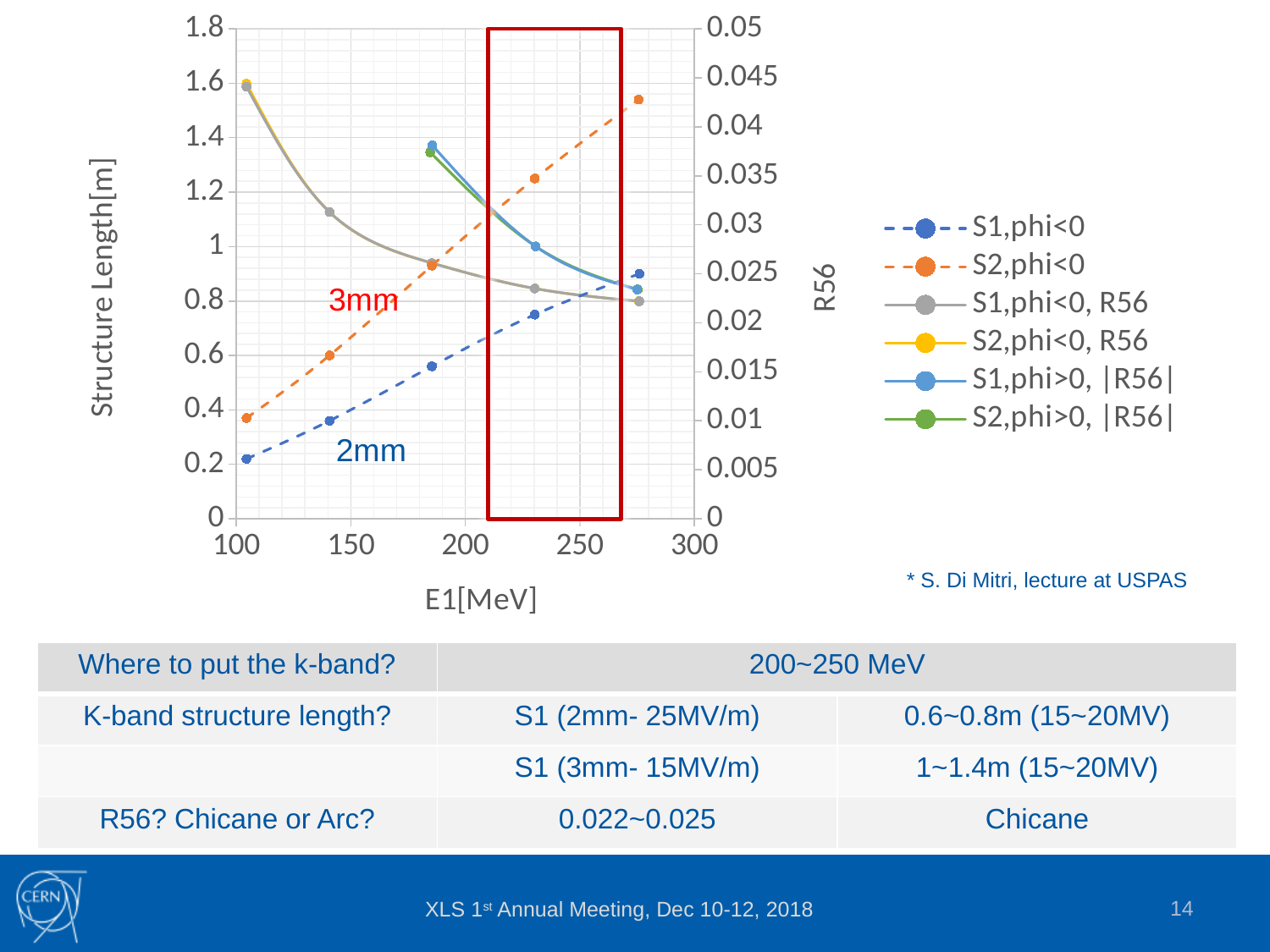
Is the structure length for S1,phi<0 at its leftmost point greater or less than 0.4? less Does the S1,phi<0 series rise or fall as E1 increases? rise What kind of chart is shown on the slide? line chart How many data points are plotted for the S1,phi<0 series? 5 Which series has the lowest structure length at the leftmost data point? S1,phi<0 What is the title of the horizontal axis? E1[MeV] Is the structure length for S2,phi<0 at its rightmost point greater or less than 1.4? greater Does the S1,phi<0, R56 series rise or fall as E1 increases? fall At the rightmost data point, which series has the larger structure length: S1,phi<0 or S2,phi<0? S2,phi<0 What is the title of the left vertical axis? Structure Length[m] How many series does the legend list? 6 Is the R56 value for S1,phi<0, R56 at its leftmost point greater or less than 0.04? greater